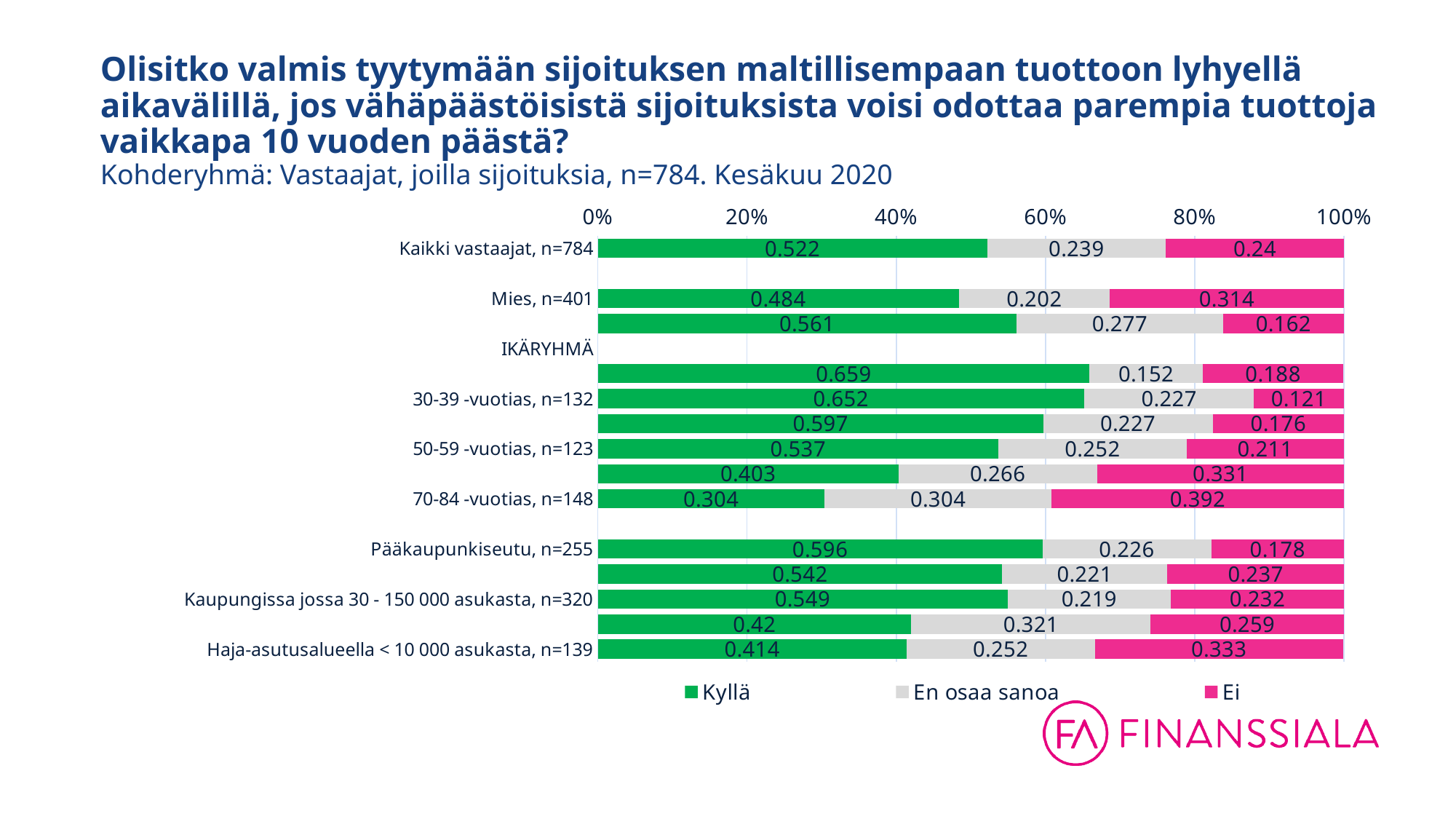
What kind of chart is shown on the slide? Stacked bar chart What is the Kyllä value for Haja-asutusalueella < 10 000 asukasta, n=139? 0.414 Which has a larger Kyllä value: 30-39 -vuotias, n=132 or 50-59 -vuotias, n=123? 30-39 -vuotias, n=132 What is the En osaa sanoa value for 70-84 -vuotias, n=148? 0.304 What is the difference between the Kyllä value for Pääkaupunkiseutu, n=255 and the Kyllä value for Haja-asutusalueella < 10 000 asukasta, n=139? 0.182 What is the Kyllä value for Kaikki vastaajat, n=784? 0.522 Which has a larger Ei value: Mies, n=401 or Kaupungissa jossa 30 - 150 000 asukasta, n=320? Mies, n=401 Which category has the highest Ei value? 70-84 -vuotias, n=148 What is the Ei value for Mies, n=401? 0.314 What is the difference between the Ei value for 70-84 -vuotias, n=148 and the Ei value for 30-39 -vuotias, n=132? 0.271 How many series does the legend list? 3 Which category has the lowest Kyllä value? 70-84 -vuotias, n=148